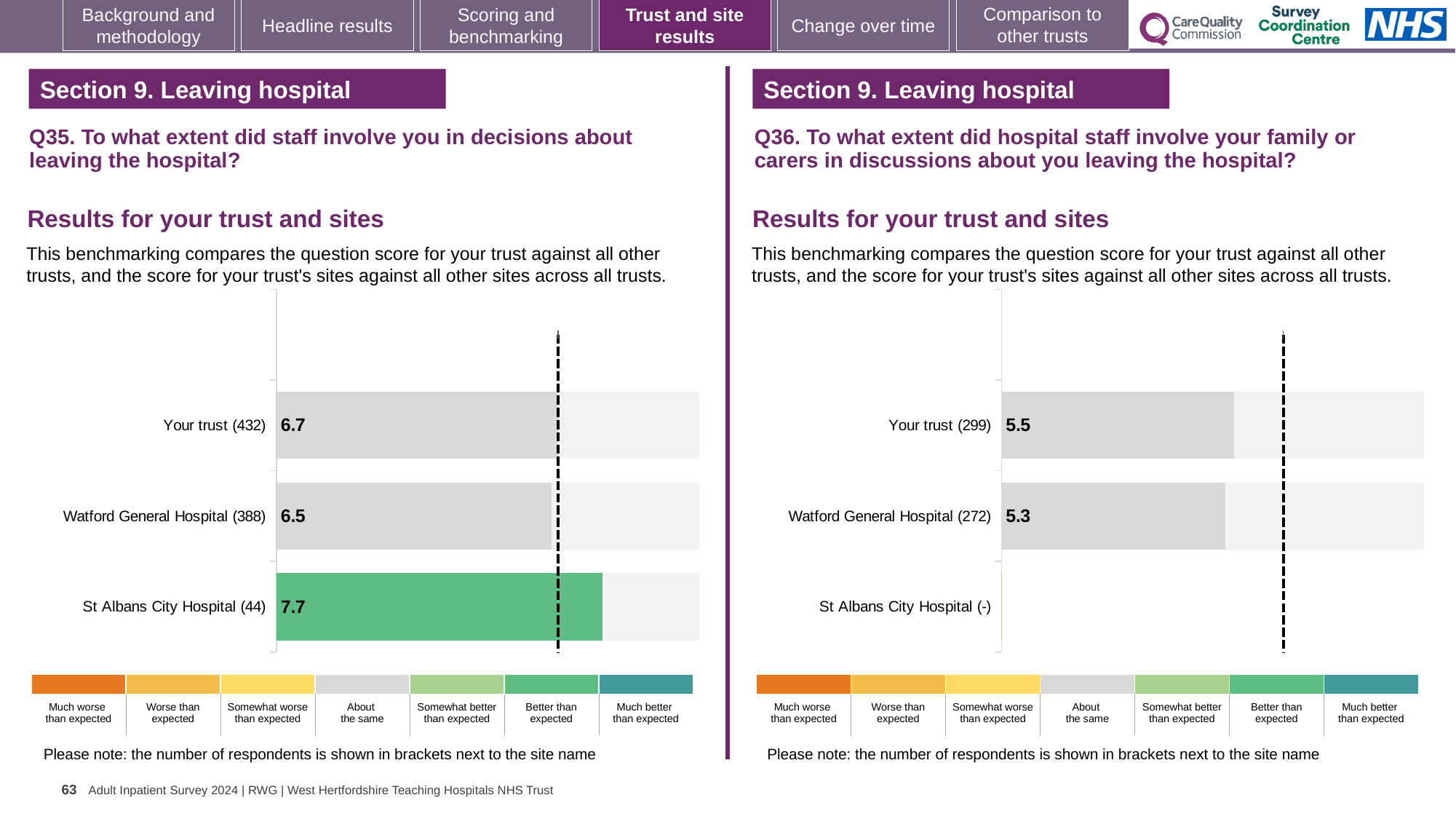
In the Q36 chart (right), what is the score for Watford General Hospital? 5.3 In the Q35 chart (left), which site or trust has the lowest score? Watford General Hospital In the Q36 chart (right), how many respondents are shown in brackets for Your trust? 299 In the Q35 chart (left), what is the score for Your trust? 6.7 In the Q35 chart (left), what colour is the bar for St Albans City Hospital? Green In the Q35 chart (left), what is the score for Watford General Hospital? 6.5 In the Q35 chart (left), what is the score for St Albans City Hospital? 7.7 In the Q35 chart (left), which site or trust has the highest score? St Albans City Hospital In the Q36 chart (right), which is larger, the score for Your trust or for Watford General Hospital? Your trust In the Q36 chart (right), what is the score for Your trust? 5.5 In the Q35 chart (left), what is the difference between the St Albans City Hospital score and the Your trust score? 1.0 What kind of chart is used on the left side of the slide for Q35? Bar chart